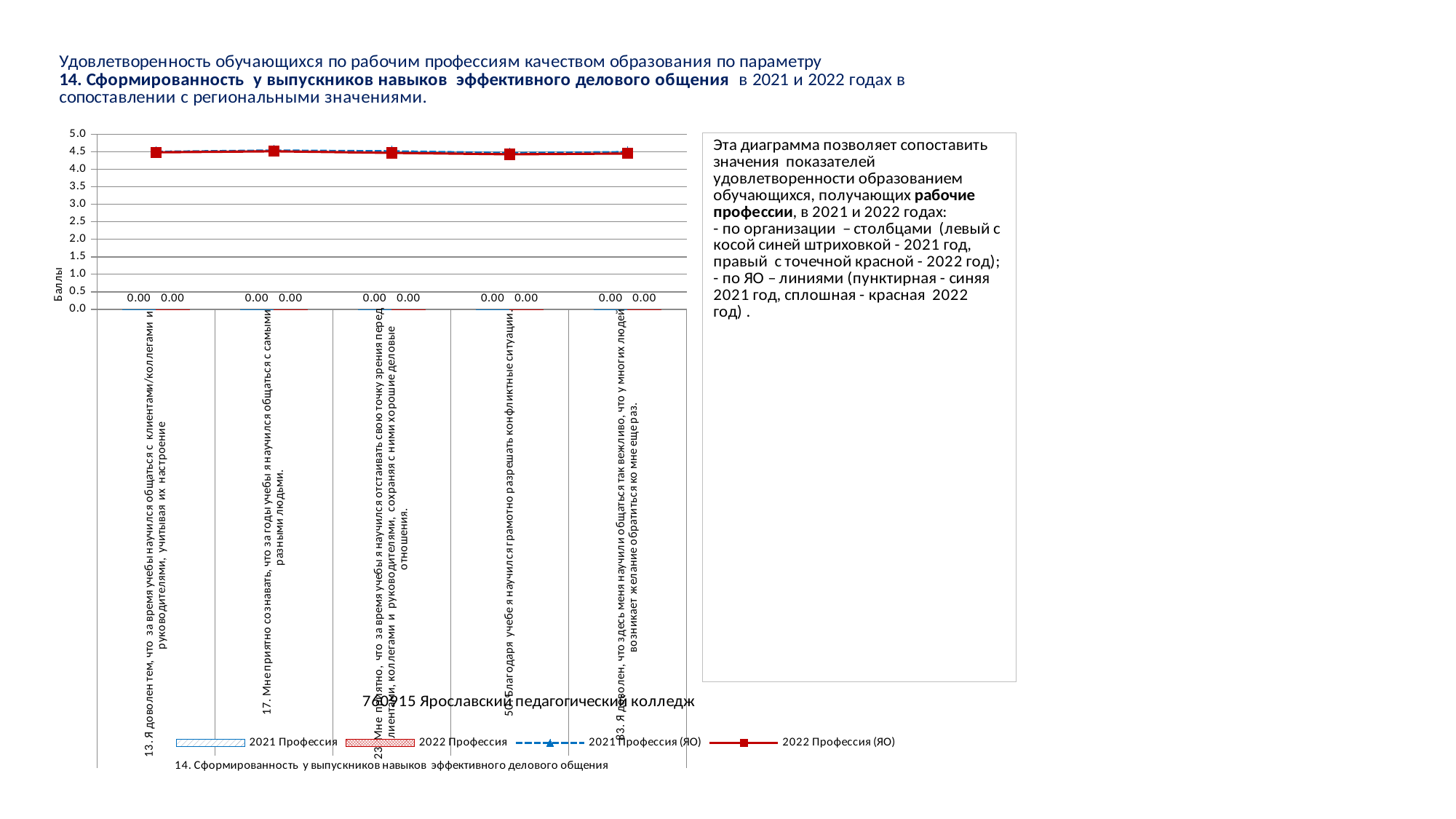
Is the value of the '2021 Профессия (ЯО)' line for statement 83 ('Я доволен, что здесь меня научили общаться так вежливо...') greater or less than 3.0? greater How many series does the chart legend list? 4 For statement 17, which is larger: the '2022 Профессия (ЯО)' line value or the '2021 Профессия' bar value? 2022 Профессия (ЯО) What is the difference between the '2021 Профессия' and '2022 Профессия' bar values for statement 13? 0.00 What is the value of the '2021 Профессия' bar for statement 13 ('Я доволен тем, что за время учебы научился общаться с клиентами/коллегами и руководителями...')? 0.00 What is the highest tick value shown on the vertical axis of the chart? 5.0 What colour is the '2022 Профессия (ЯО)' line in the chart? Red How many categories (statements) are shown along the x axis of the chart? 5 Is the value of the '2022 Профессия (ЯО)' line for statement 17 ('Мне приятно сознавать, что за годы учебы я научился общаться с самыми разными людьми') greater or less than 4.0? greater What kind of chart is shown on the slide? Combined bar and line chart What is the title of the vertical axis of the chart? Баллы